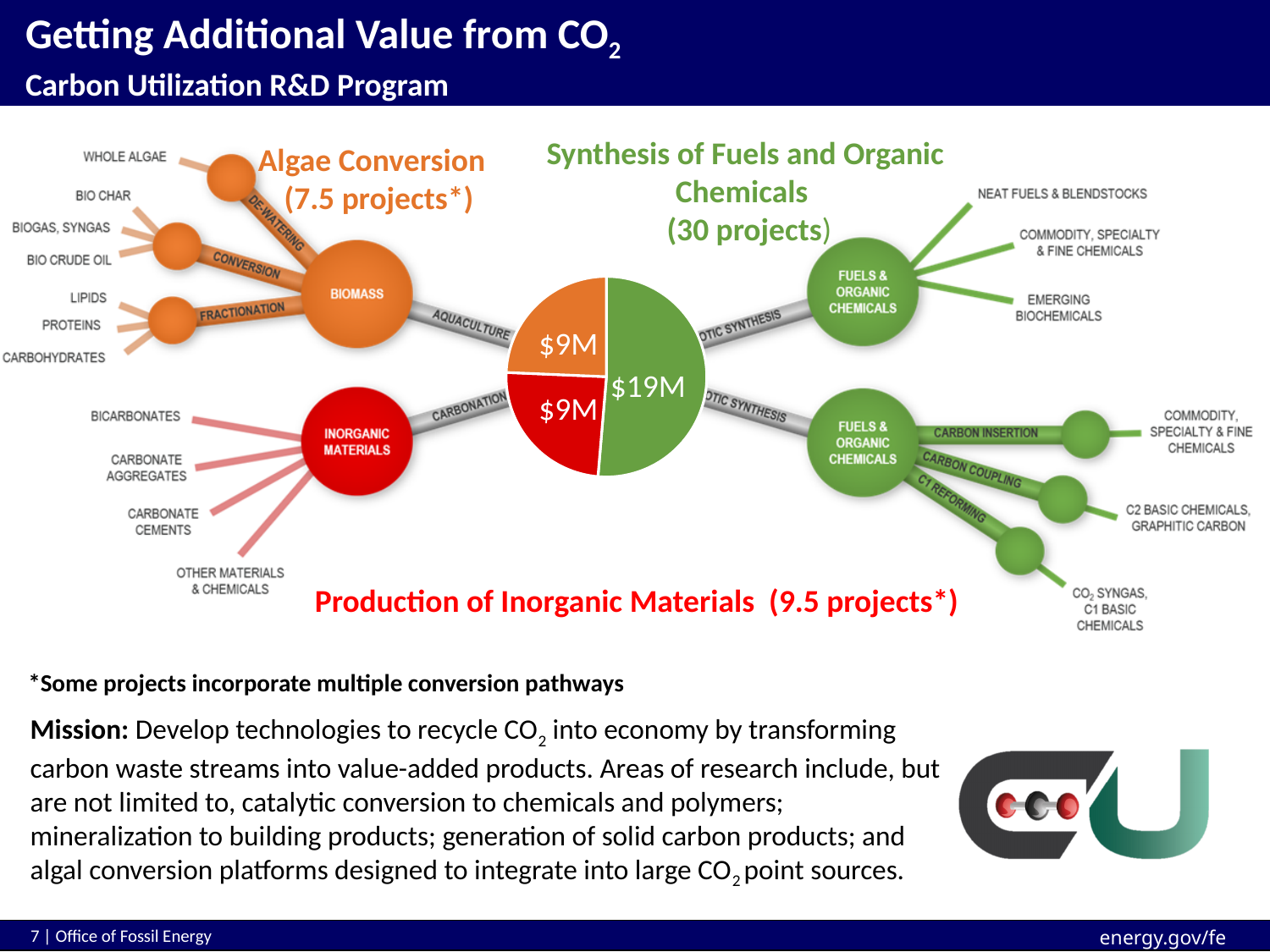
Are the Algae Conversion and Production of Inorganic Materials slices equal in value? yes What is the value of the green slice (Synthesis of Fuels and Organic Chemicals) in the pie chart? $19M What is the value of the red slice (Production of Inorganic Materials) in the pie chart? $9M What is the value of the orange slice (Algae Conversion) in the pie chart? $9M What is the difference between the Synthesis of Fuels and Organic Chemicals slice and the Algae Conversion slice? $10M What kind of chart is shown in the centre of the slide? pie chart How many projects does the Synthesis of Fuels and Organic Chemicals label show? 30 projects How many slices does the pie chart have? 3 Which is larger in the pie chart: Synthesis of Fuels and Organic Chemicals or Production of Inorganic Materials? Synthesis of Fuels and Organic Chemicals Which pathway has the largest slice in the pie chart? Synthesis of Fuels and Organic Chemicals What colour is the Algae Conversion slice in the pie chart? orange What is the total of all three slices in the pie chart? $37M